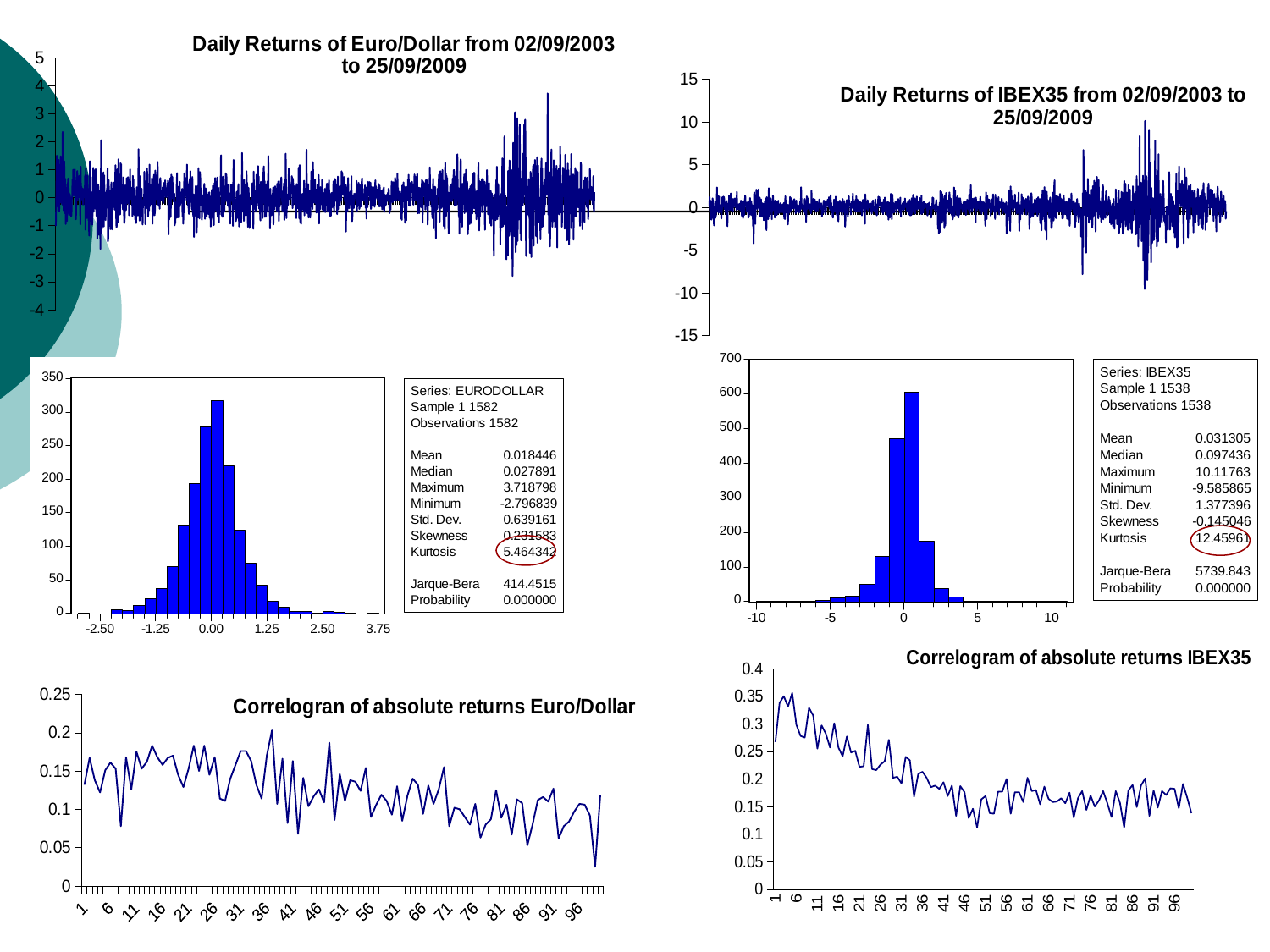
In the EURODOLLAR histogram, is the tallest bar greater or less than 300? greater In the IBEX35 statistics box, what is the Maximum value? 10.11763 Which series has the larger Kurtosis, EURODOLLAR or IBEX35? IBEX35 In the EURODOLLAR statistics box, what is the Std. Dev. value? 0.639161 In the 'Correlogram of absolute returns IBEX35' chart, do the values generally rise or fall along the x axis? fall What kind of chart is the histogram for the EURODOLLAR series (bottom-left middle chart)? bar chart In the IBEX35 statistics box, what is the Kurtosis value? 12.45961 What kind of chart is the 'Daily Returns of Euro/Dollar from 02/09/2003 to 25/09/2009' chart? line chart What is the title of the chart in the top-right of the slide? Daily Returns of IBEX35 from 02/09/2003 to 25/09/2009 In the IBEX35 histogram, is the tallest bar greater or less than 500? greater What is the difference between the number of observations for EURODOLLAR (1582) and IBEX35 (1538)? 44 In the EURODOLLAR statistics box, what is the Kurtosis value? 5.464342